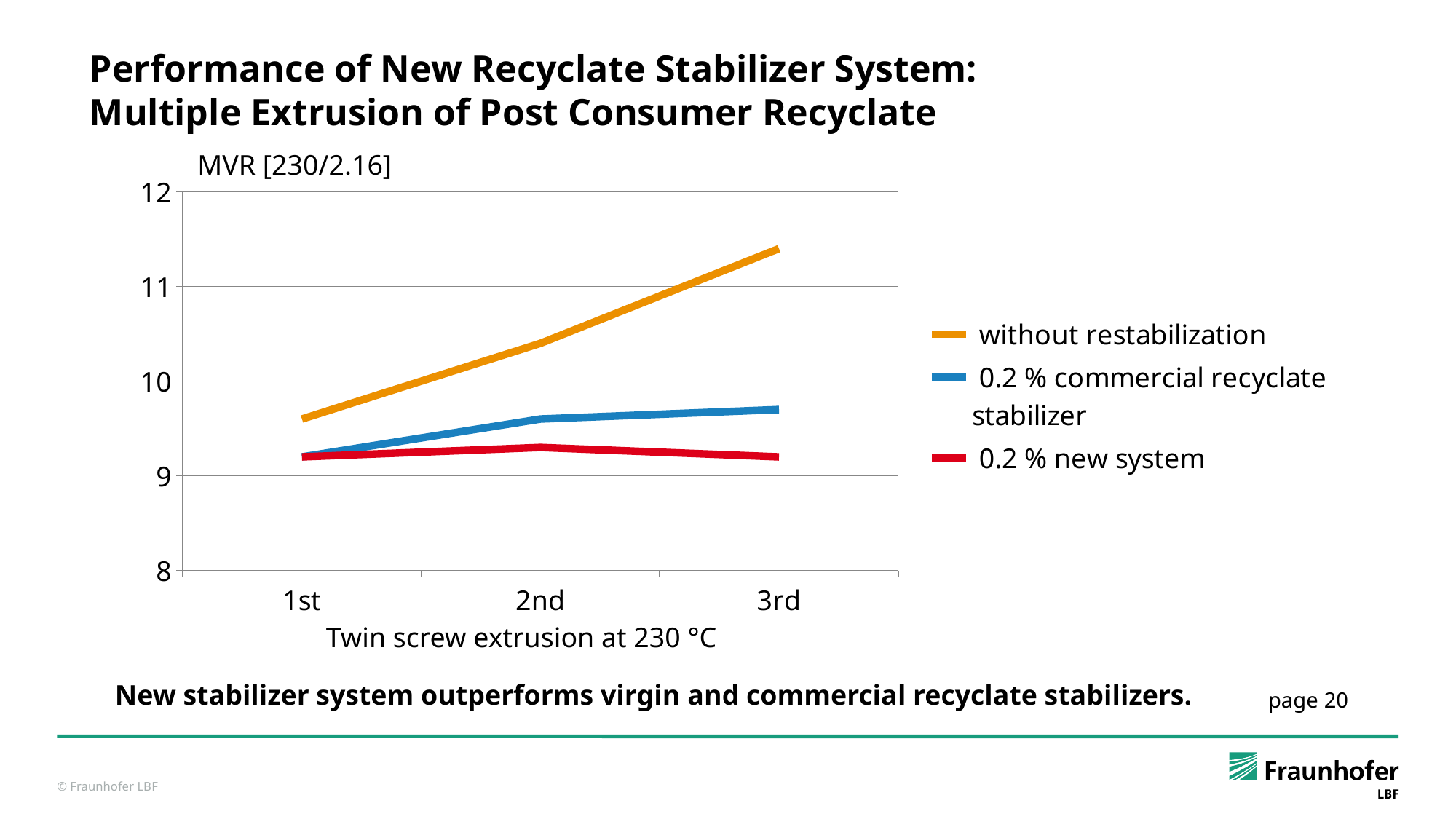
Is the value for 'without restabilization' at the 3rd extrusion greater or less than 11? greater What is the x-axis title of the chart? Twin screw extrusion at 230 °C How many series does the legend list? 3 Which series has the highest MVR value at the 3rd extrusion? without restabilization Is the value for '0.2 % commercial recyclate stabilizer' at the 3rd extrusion greater or less than 10? less Is the value for 'without restabilization' at the 1st extrusion greater or less than 10? less Does the 'without restabilization' series rise or fall from the 1st to the 3rd extrusion? rise How many extrusion passes are shown along the x axis? 3 At the 2nd extrusion, which is larger: the value for '0.2 % commercial recyclate stabilizer' or for '0.2 % new system'? 0.2 % commercial recyclate stabilizer Which series has the lowest MVR value at the 3rd extrusion? 0.2 % new system What kind of chart is shown on the slide? line chart